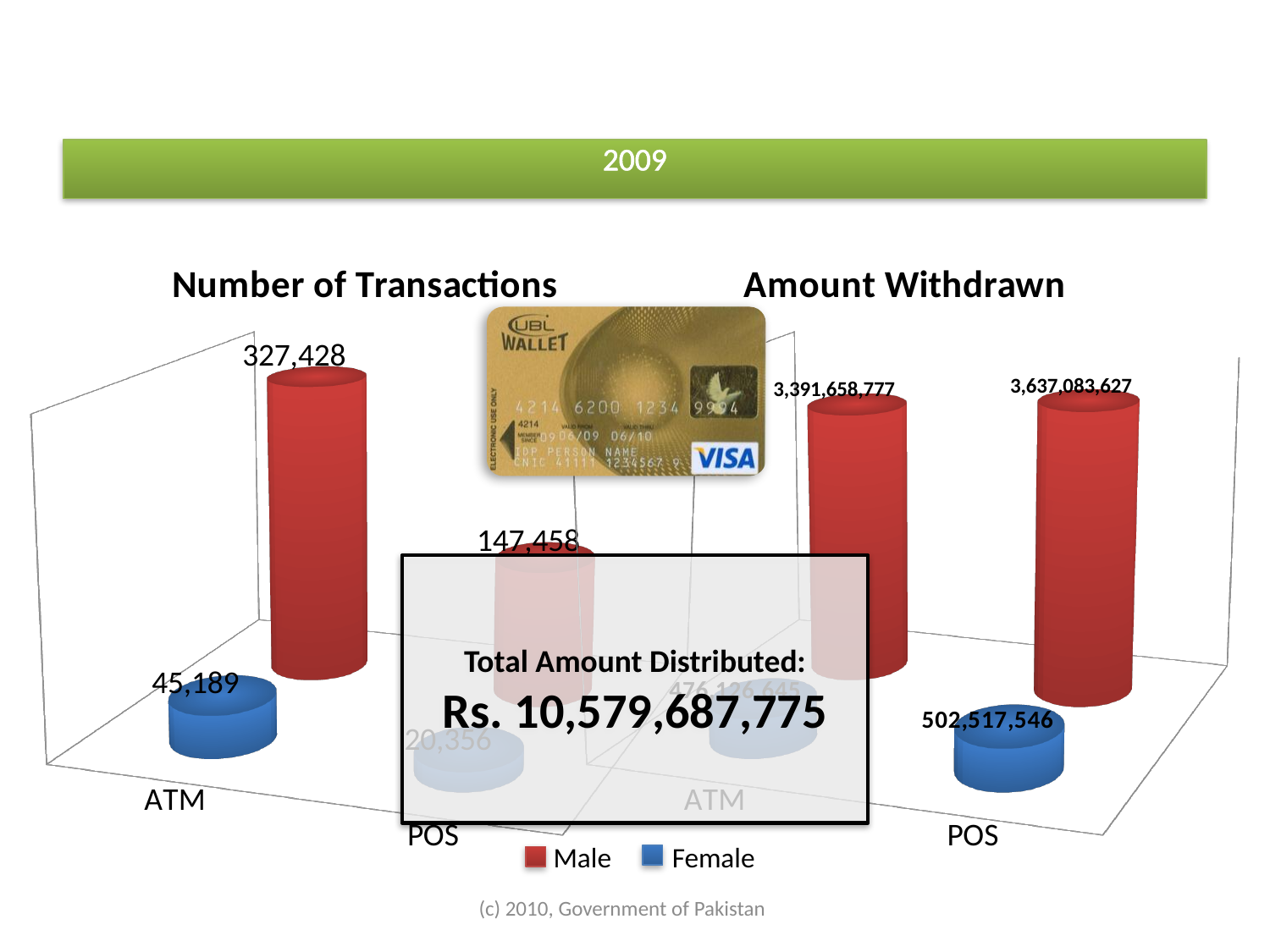
In the Amount Withdrawn chart, what is the value for Male at ATM? 3,391,658,777 What kind of chart is the Number of Transactions chart? Bar chart How many series does the legend list? 2 In the Number of Transactions chart, which is larger for Male: ATM or POS? ATM In the Number of Transactions chart, what is the difference between Male and Female at ATM? 282,239 In the Number of Transactions chart, what is the value for Male at ATM? 327,428 In the Amount Withdrawn chart, which category and series has the highest value? Male at POS In the Amount Withdrawn chart, which is larger for Male: ATM or POS? POS In the Amount Withdrawn chart, what is the value for Male at POS? 3,637,083,627 In the Number of Transactions chart, what is the value for Male at POS? 147,458 In the Number of Transactions chart, what is the value for Female at ATM? 45,189 In the Amount Withdrawn chart, what is the value for Female at POS? 502,517,546